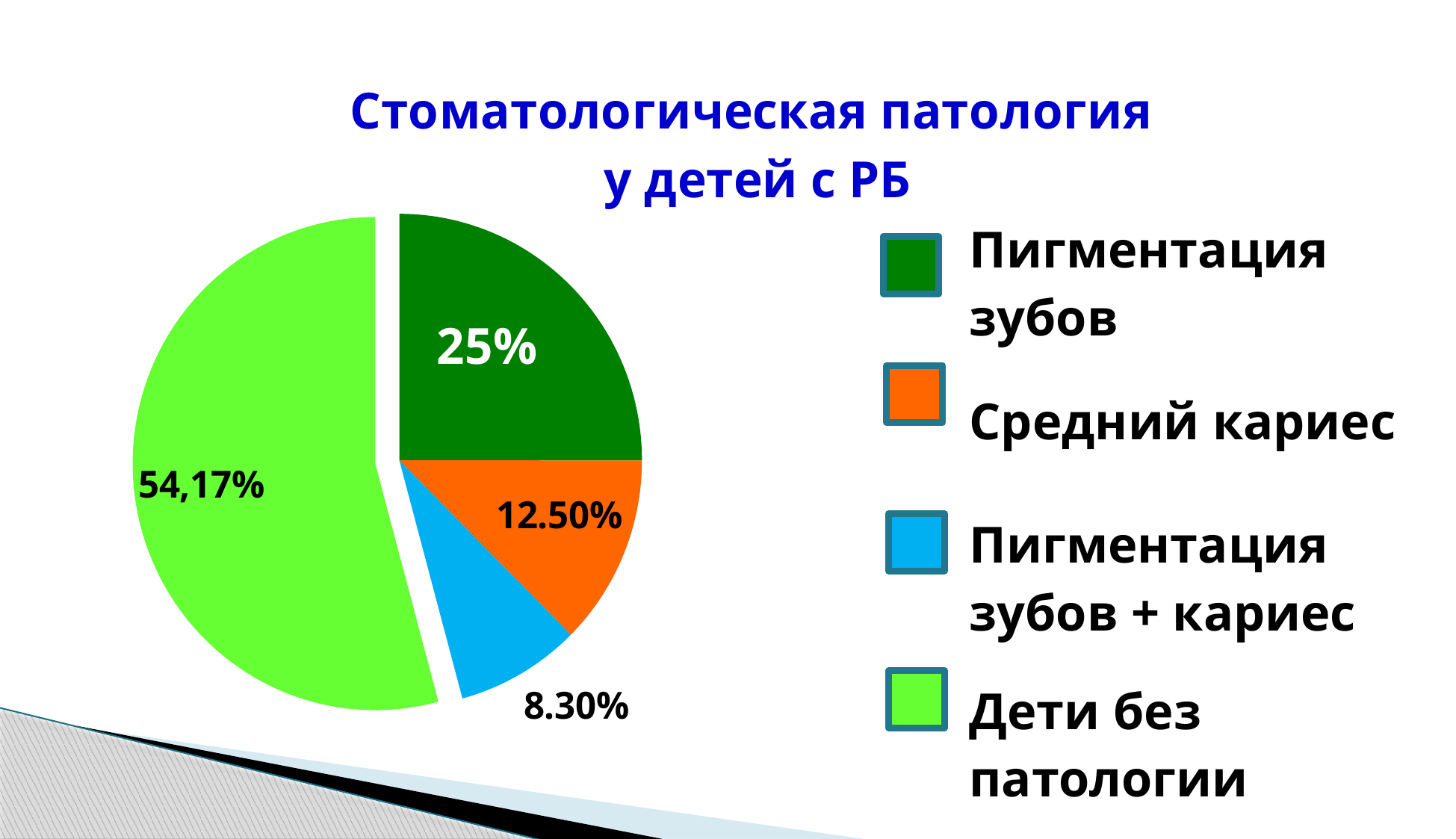
What is the difference between the values for Пигментация зубов and Пигментация зубов + кариес? 16.70% Which is larger, the value for Средний кариес or the value for Пигментация зубов + кариес? Средний кариес Which category has the largest share of the pie? Дети без патологии What is the value for Пигментация зубов + кариес? 8.30% What is the value for Средний кариес? 12.50% What is the value for Дети без патологии? 54,17% What kind of chart is shown on the slide? pie chart What is the difference between the values for Пигментация зубов and Средний кариес? 12.50% How many categories does the pie chart have? 4 What is the value for Пигментация зубов? 25% What is the title of the chart? Стоматологическая патология у детей с РБ Which category has the smallest share of the pie? Пигментация зубов + кариес